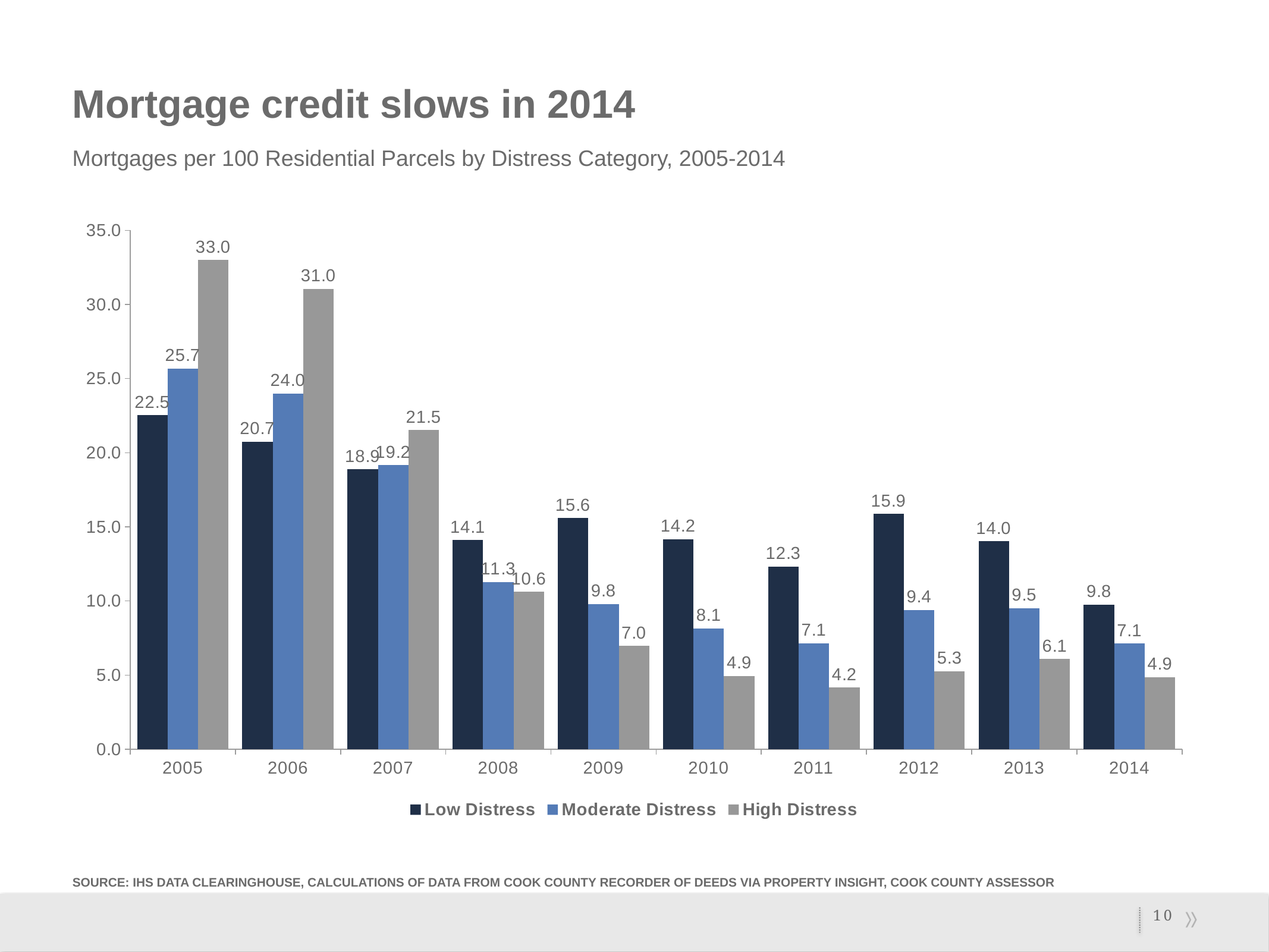
How many years are shown on the x axis? 10 What is the value for Moderate Distress in 2010? 8.1 What is the value for High Distress in 2005? 33.0 What kind of chart is shown on the slide? Bar chart Which year has the lowest value for Moderate Distress? 2011 and 2014 (both 7.1) What is the value for Low Distress in 2014? 9.8 Which is larger in 2008: Moderate Distress or High Distress? Moderate Distress What is the title of the slide? Mortgage credit slows in 2014 What is the difference between the Low Distress and High Distress values in 2014? 4.9 Do the High Distress values generally rise or fall from 2005 to 2011? Fall How many series does the legend list? 3 Which year has the highest value for High Distress? 2005